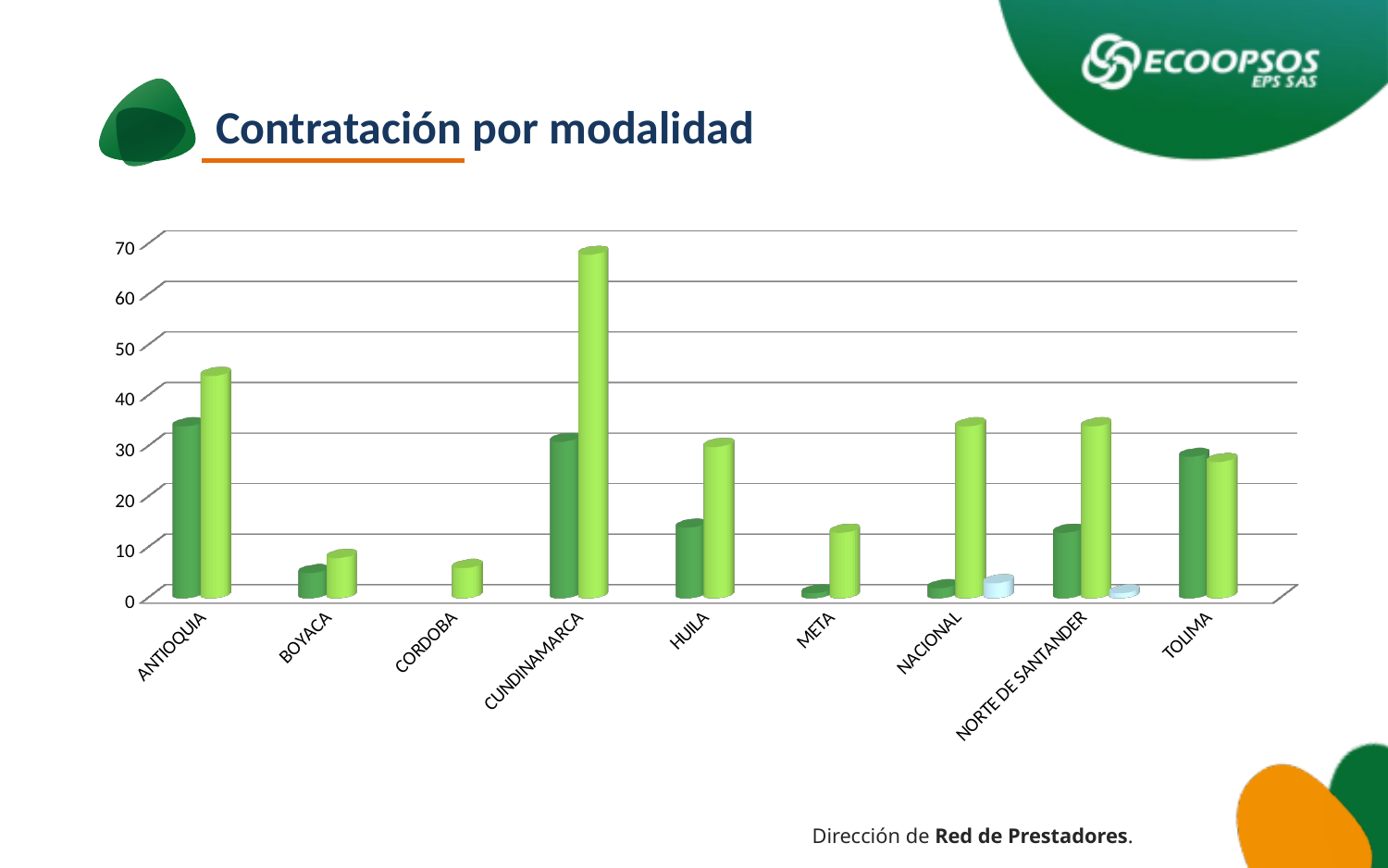
What kind of chart is shown on the slide? bar chart Is the dark green bar for TOLIMA greater or less than 20? greater Is the dark green bar for ANTIOQUIA greater or less than 20? greater Which category has the tallest bar in the chart? CUNDINAMARCA Which is larger, the dark green bar for ANTIOQUIA or the dark green bar for BOYACA? ANTIOQUIA Is the light green bar for BOYACA greater or less than 10? less How many categories are shown along the x axis of the chart? 9 What is the title of the slide containing the chart? Contratación por modalidad Which is larger, the light green bar for CUNDINAMARCA or the light green bar for ANTIOQUIA? CUNDINAMARCA